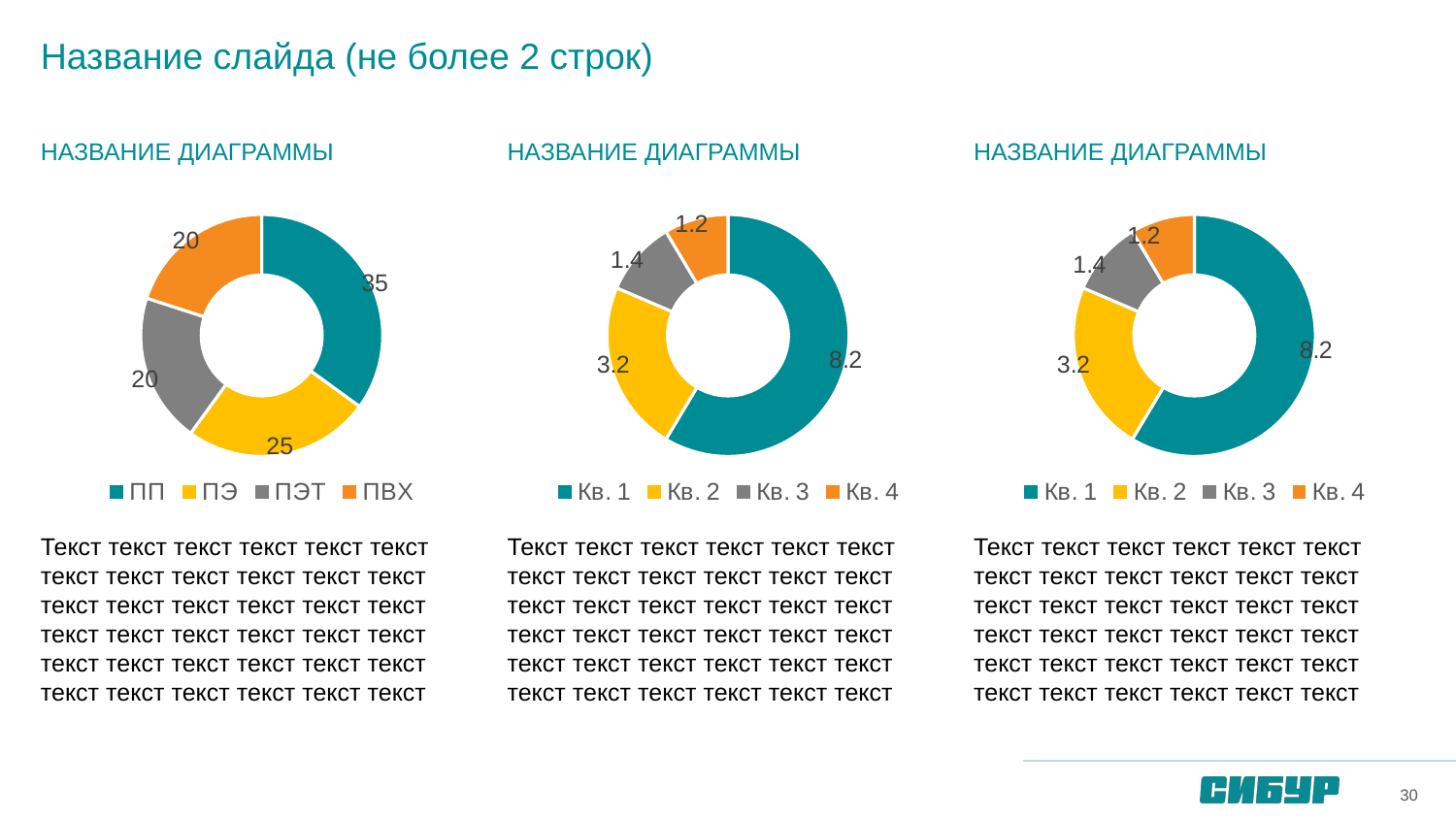
In the left chart, what is the difference between the values for ПП and ПЭ? 10 In the middle chart, what is the value for Кв. 1? 8.2 In the left chart, what share of the total does ПП represent? 35% In the right chart, what is the total of all four values? 14 In the left chart, what is the value for ПЭ? 25 What kind of chart is the middle chart? doughnut chart In the middle chart, what is the difference between the values for Кв. 2 and Кв. 3? 1.8 In the right chart, which is larger, the value for Кв. 2 or the value for Кв. 3? Кв. 2 How many categories does the legend of the left chart list? 4 In the left chart, which category has the largest value? ПП In the middle chart, which category has the smallest value? Кв. 4 In the left chart, what is the value for ПП? 35